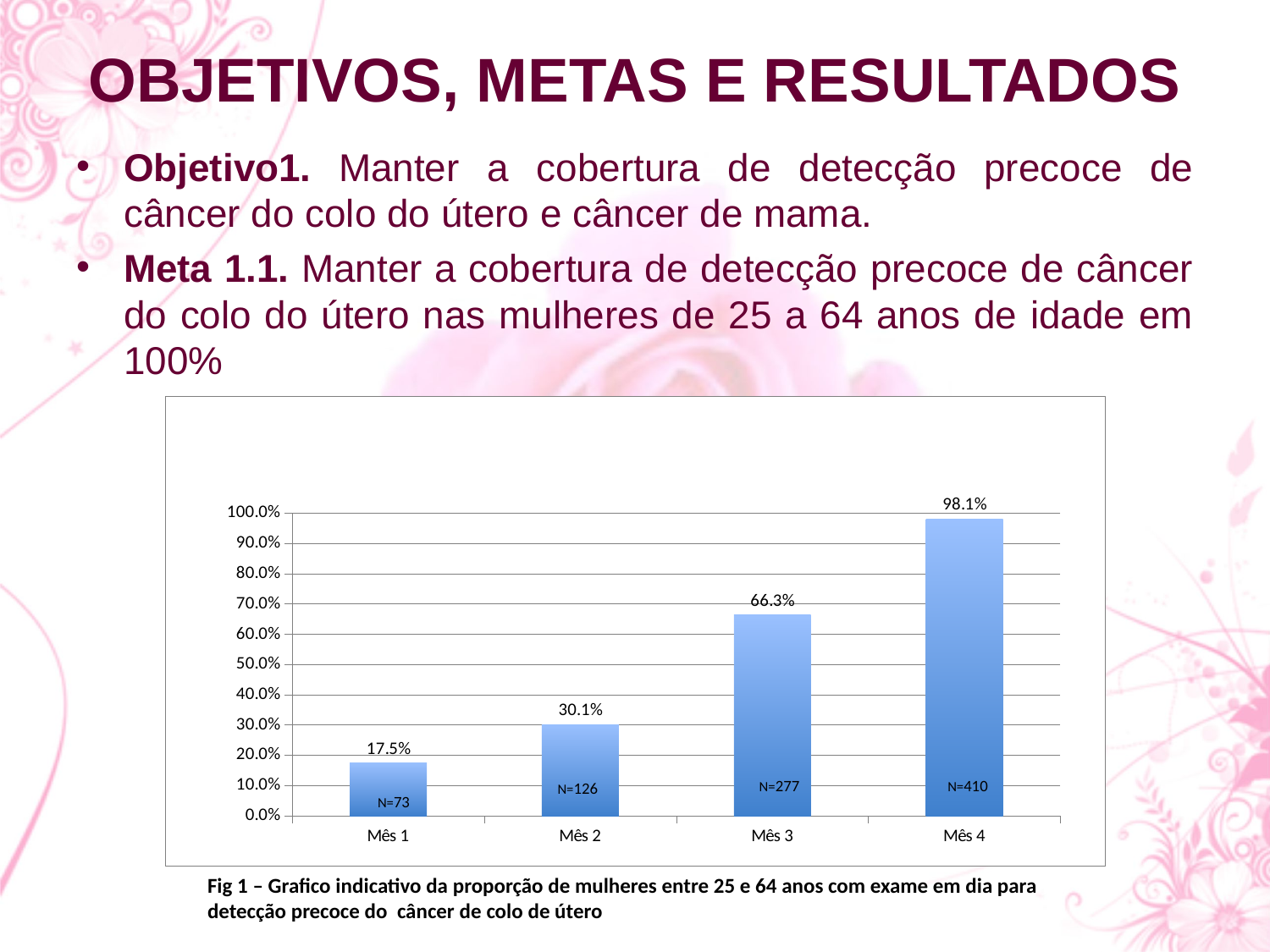
How many months are shown on the x axis? 4 Which month has the lowest value? Mês 1 What is the difference between the values for Mês 4 and Mês 3? 31.8% What is the value for Mês 3? 66.3% What is the difference between the values for Mês 2 and Mês 1? 12.6% Do the values rise or fall from Mês 1 to Mês 4? Rise Which is larger, the value for Mês 2 or the value for Mês 3? Mês 3 What is the value for Mês 4? 98.1% What kind of chart is shown on the slide? Bar chart Which month has the highest value? Mês 4 What is the N value shown inside the bar for Mês 2? N=126 What is the value for Mês 1? 17.5%